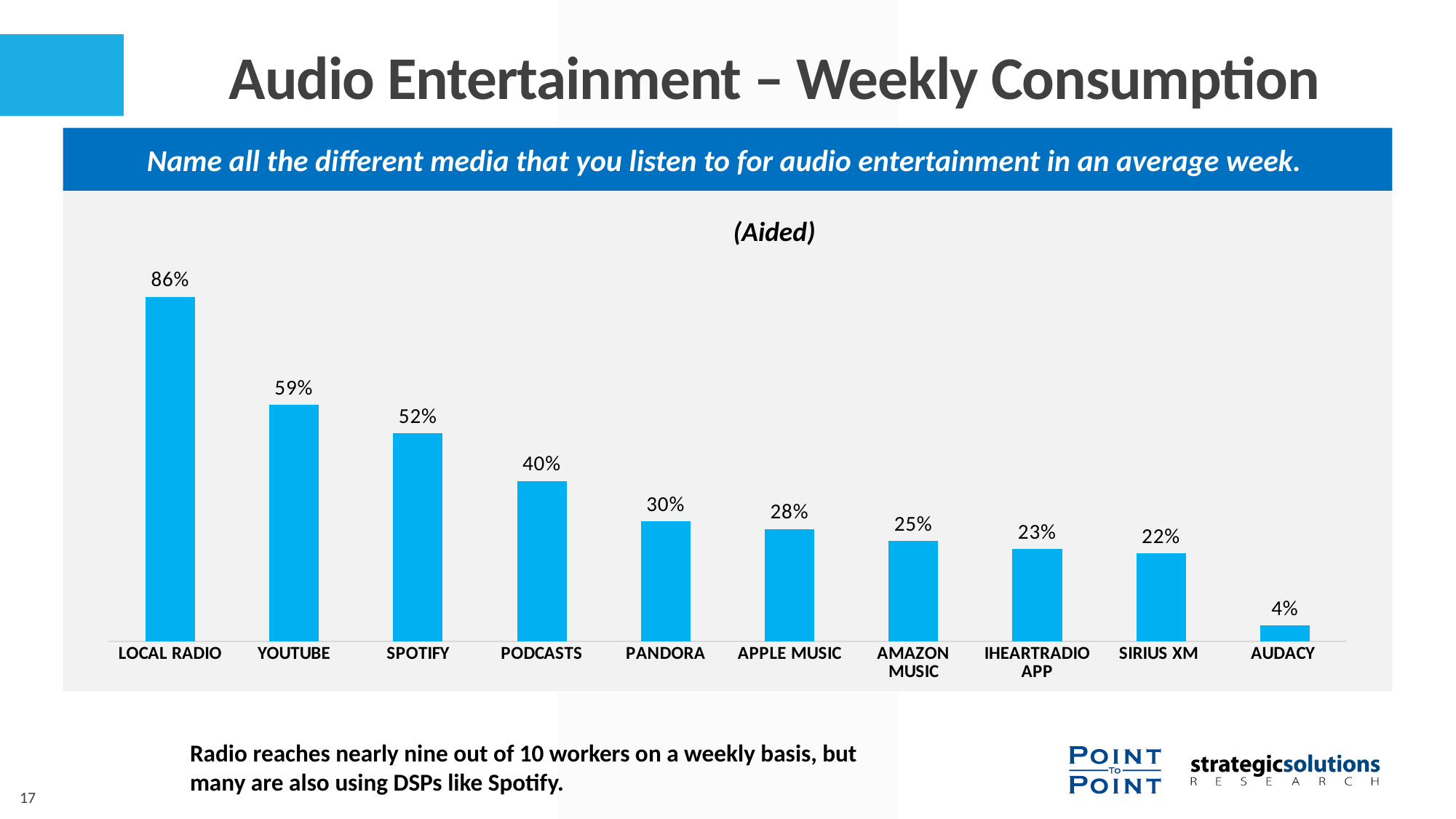
What percentage of respondents listen to Local Radio in an average week? 86% Which has a higher value, Pandora or Apple Music? Pandora How many media categories are shown in the chart? 10 How much higher is Local Radio's value than Podcasts' value? 46% Which media has the lowest weekly consumption in the chart? Audacy What is the value shown for Spotify? 52% What percentage is shown for the iHeartRadio App? 23% What is the difference between the values for YouTube and Spotify? 7% What type of chart is shown on the slide? Bar chart Do the values rise or fall moving from left to right across the chart? Fall Which media has the highest weekly consumption in the chart? Local Radio Which has a higher value, Sirius XM or Amazon Music? Amazon Music